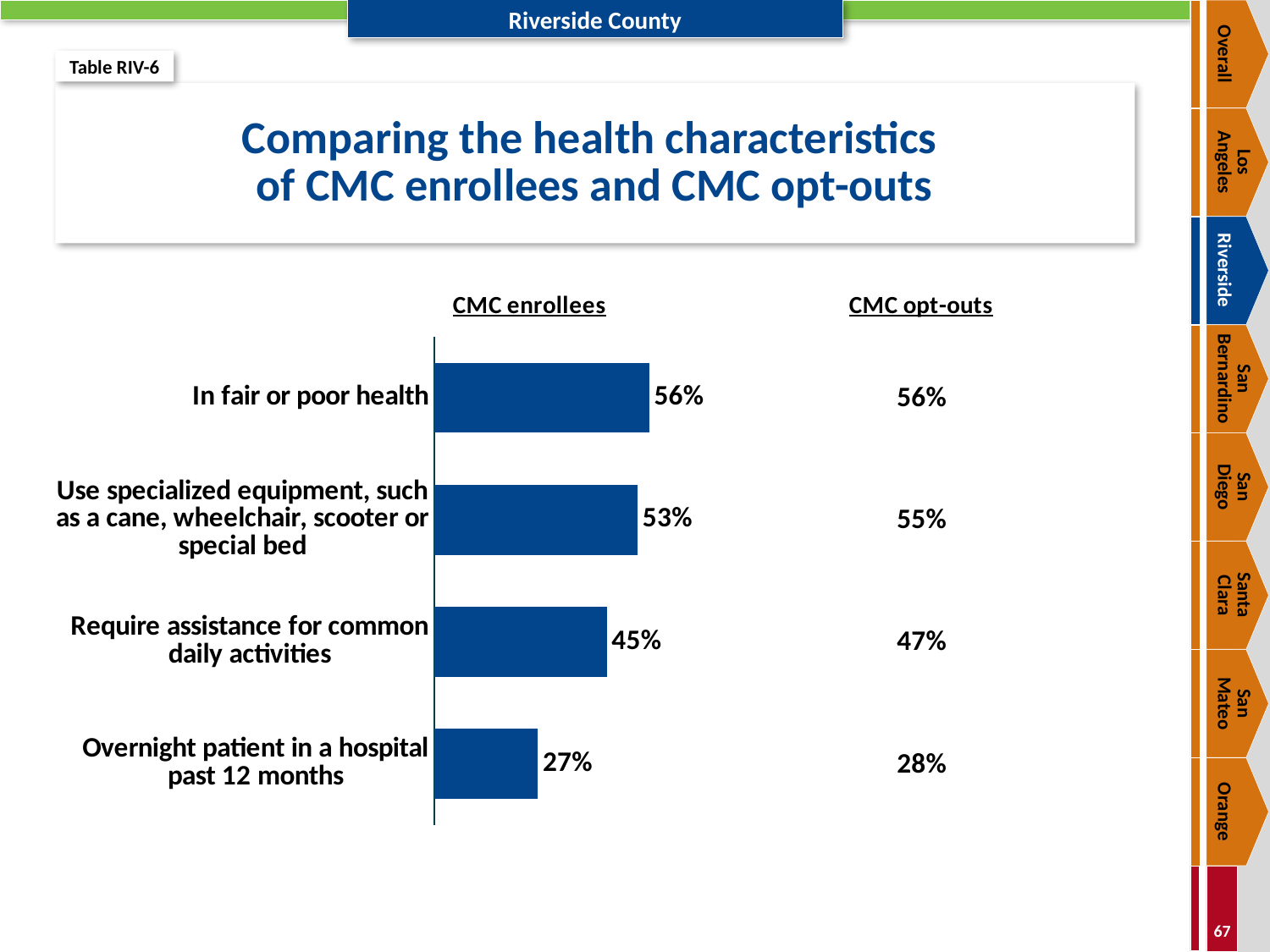
What is the difference between the CMC enrollees values for in fair or poor health and overnight patient in a hospital past 12 months? 29% What is the title of the chart? Comparing the health characteristics of CMC enrollees and CMC opt-outs What is the value for CMC enrollees who require assistance for common daily activities? 45% For using specialized equipment, which group has the larger value, CMC enrollees or CMC opt-outs? CMC opt-outs What type of chart is used to show the CMC enrollees values? Bar chart What is the value for CMC enrollees in fair or poor health? 56% What percentage of CMC enrollees use specialized equipment, such as a cane, wheelchair, scooter or special bed? 53% What is the CMC opt-outs value for requiring assistance for common daily activities? 47% What percentage of CMC enrollees were an overnight patient in a hospital in the past 12 months? 27% How many health characteristics are shown in the chart? 4 Which health characteristic has the highest value for CMC enrollees? In fair or poor health Which health characteristic has the lowest value for CMC enrollees? Overnight patient in a hospital past 12 months